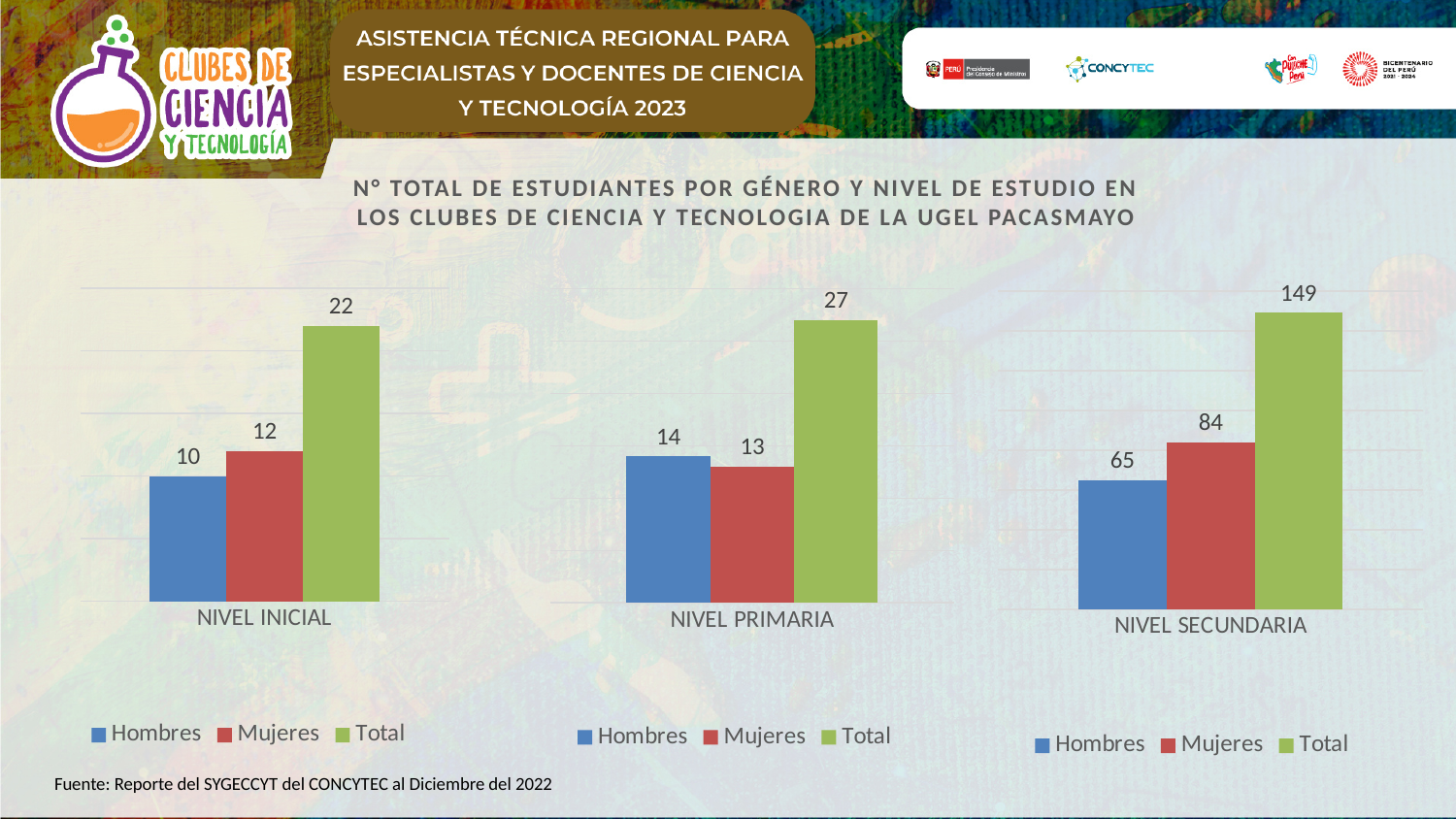
In the NIVEL PRIMARIA chart, which series has the lowest value? Mujeres In the NIVEL PRIMARIA chart, what is the value for Total? 27 In the NIVEL SECUNDARIA chart, which series has the highest value? Total In the NIVEL SECUNDARIA chart, what is the value for Mujeres? 84 In the NIVEL INICIAL chart, what is the value for Hombres? 10 In the NIVEL INICIAL chart, what is the difference between Total and Mujeres? 10 In the NIVEL SECUNDARIA chart, what is the value for Hombres? 65 What kind of chart is used for NIVEL SECUNDARIA? Bar chart In the NIVEL PRIMARIA chart, which is larger, Hombres or Mujeres? Hombres In the NIVEL SECUNDARIA chart, what is the difference between Mujeres and Hombres? 19 In the NIVEL INICIAL chart, what is the value for Mujeres? 12 How many series does the legend of the NIVEL INICIAL chart list? 3